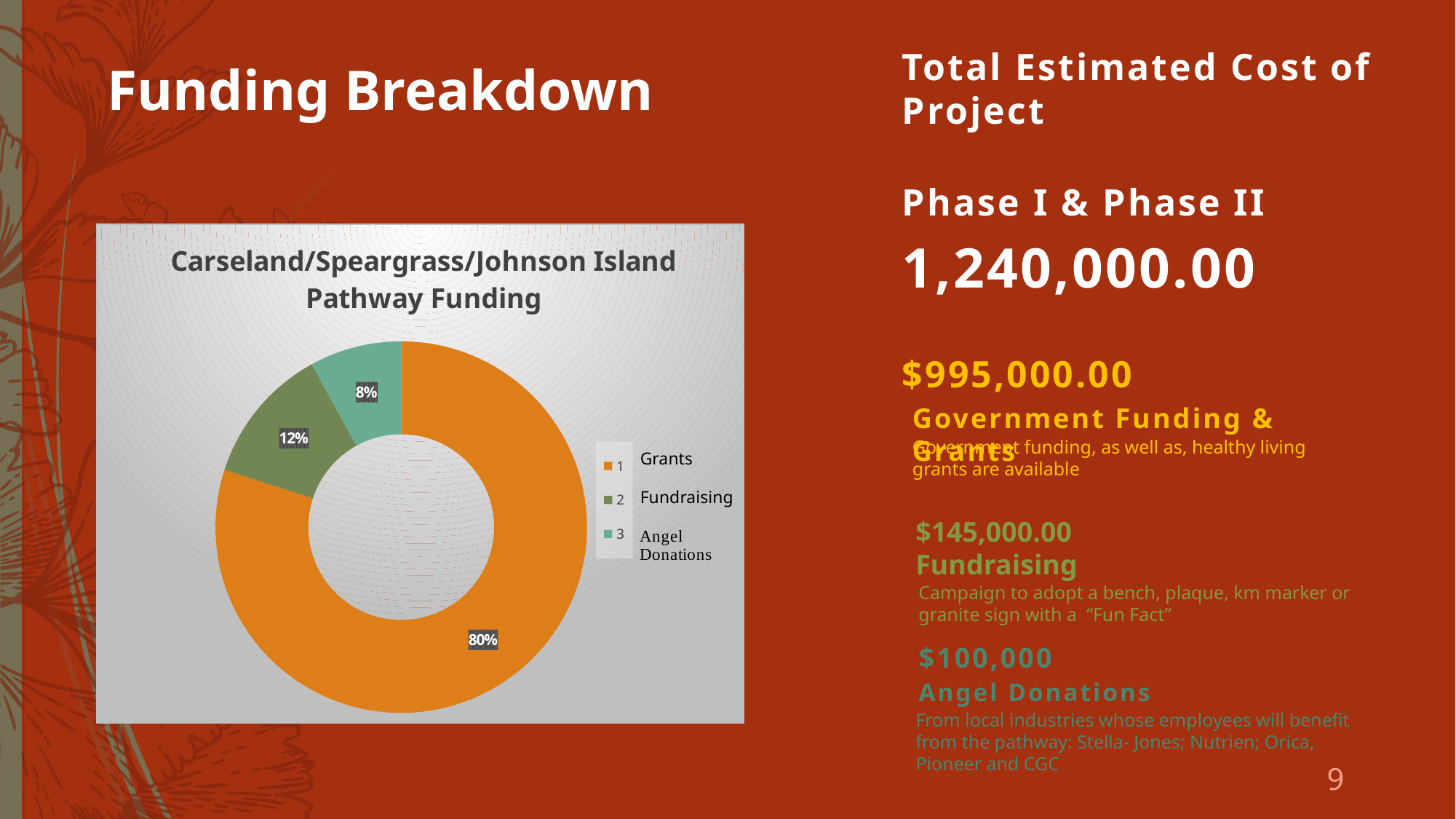
What colour is the Grants slice in the chart? Orange What is the difference in percentage points between the Grants share and the Fundraising share? 68 Which funding source has the smallest share of the chart? Angel Donations Which is larger, the Fundraising share or the Angel Donations share? Fundraising Which funding source has the largest share of the chart? Grants What percentage of the pathway funding comes from Angel Donations? 8% What percentage of the pathway funding comes from Grants? 80% What type of chart is shown on the slide? Doughnut (pie) chart What is the combined share of Fundraising and Angel Donations? 20% What is the title of the chart? Carseland/Speargrass/Johnson Island Pathway Funding How many slices does the chart have? 3 What percentage of the pathway funding comes from Fundraising? 12%